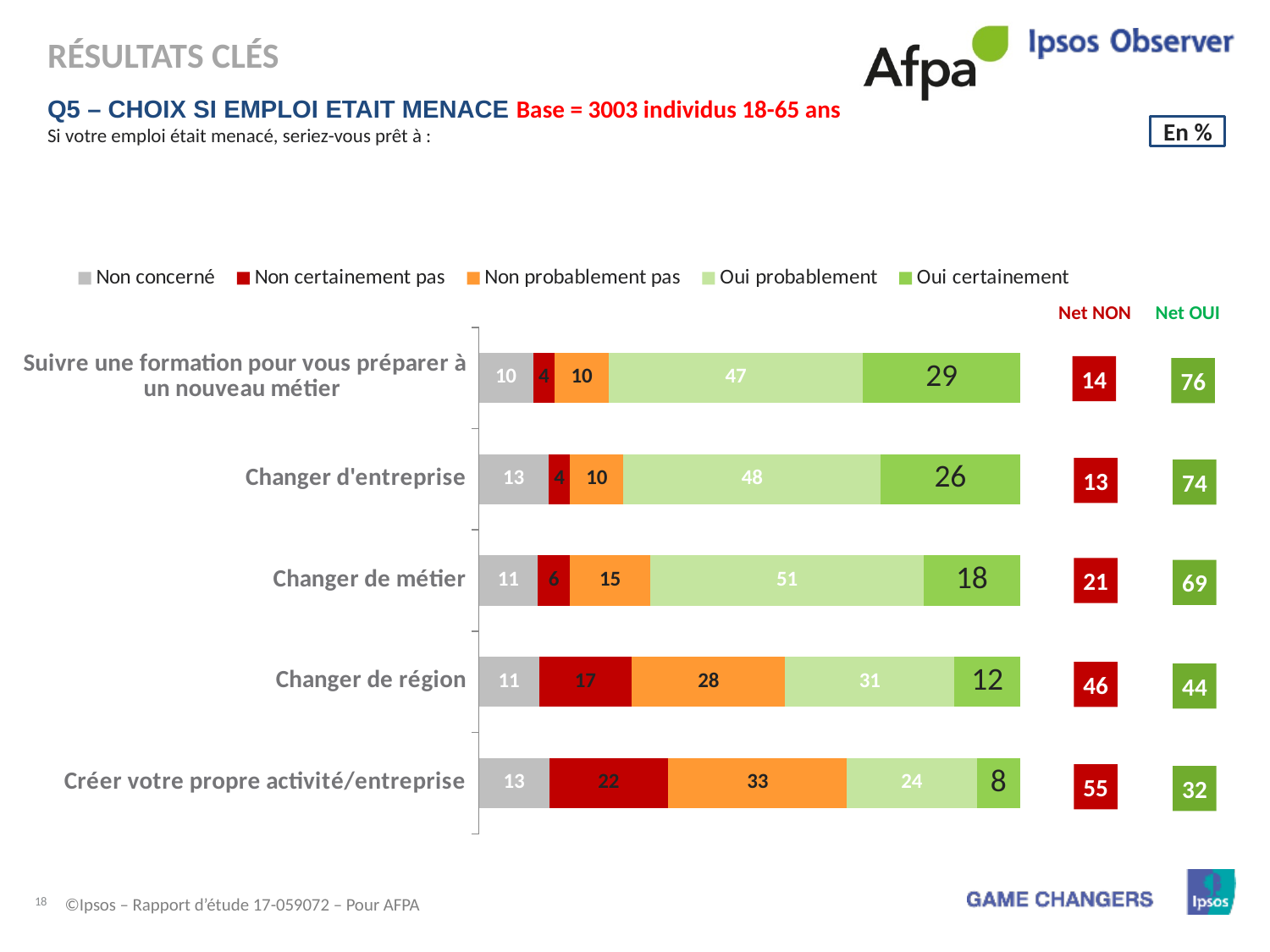
What is the total of the stacked bar for "Suivre une formation pour vous préparer à un nouveau métier"? 100 What is the value of "Non certainement pas" for "Créer votre propre activité/entreprise"? 22 How many series does the legend list? 5 Which has a larger "Oui probablement" value: "Suivre une formation pour vous préparer à un nouveau métier" or "Changer de région"? Suivre une formation pour vous préparer à un nouveau métier Which category has the lowest value for "Oui certainement"? Créer votre propre activité/entreprise What kind of chart is shown on the slide? Stacked bar chart What is the value of "Oui certainement" for "Changer de métier"? 18 What is the difference between the "Non probablement pas" values for "Changer de région" and "Changer d'entreprise"? 18 What is the value of "Non concerné" for "Changer d'entreprise"? 13 How many categories are shown in the chart? 5 What is the first entry in the chart legend? Non concerné Which category has the highest value for "Oui probablement"? Changer de métier